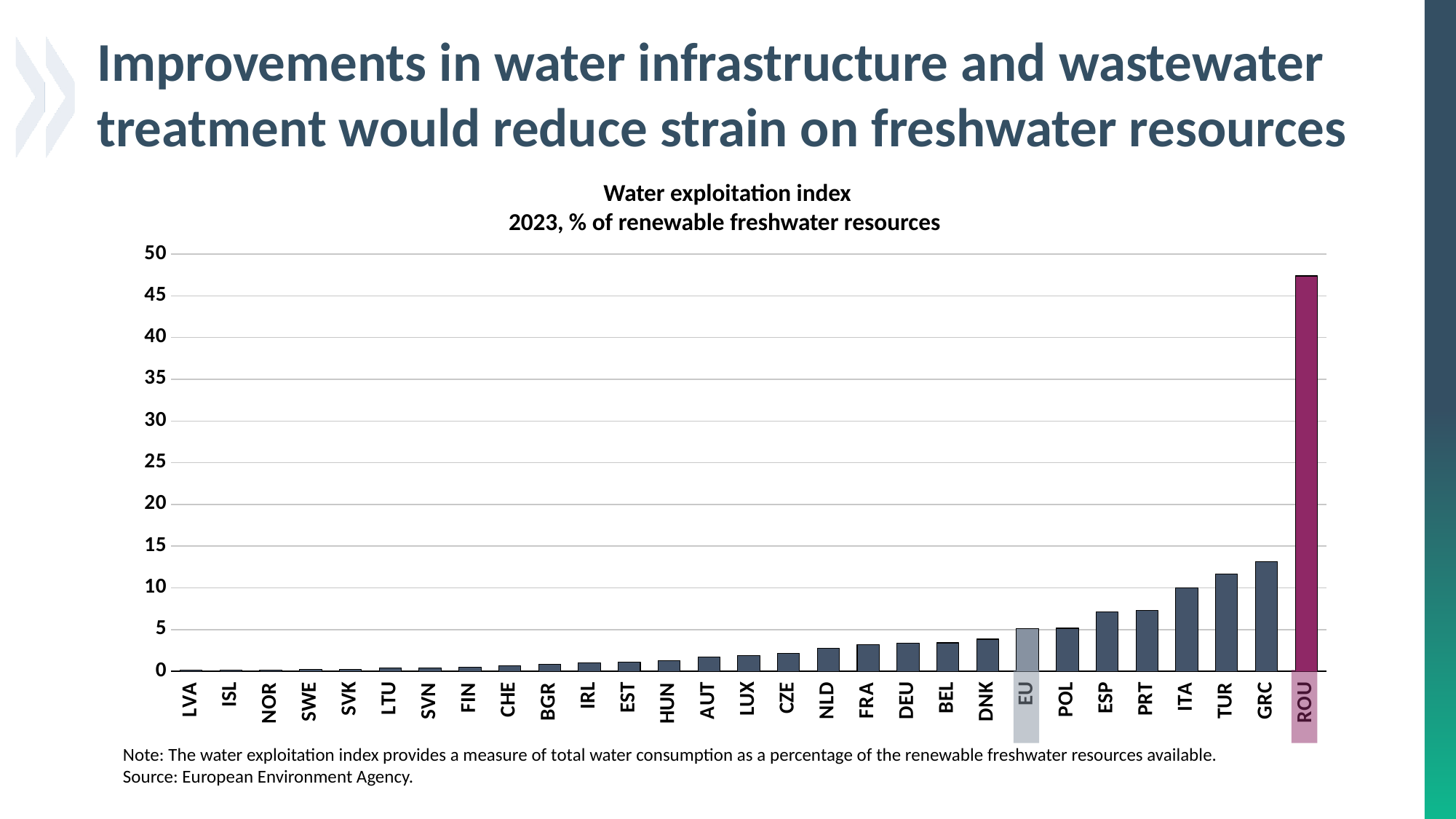
Which has a higher water exploitation index, FRA or LVA? FRA What is the title of the chart? Water exploitation index Is the value for ESP greater or less than 10? less Which country has the highest water exploitation index in the chart? ROU Which has a higher water exploitation index, TUR or ESP? TUR Is the value for TUR greater or less than 10? greater How many categories are shown on the x axis of the chart? 29 Is the value for ROU greater or less than 45? greater Do the bar values rise or fall moving from left to right along the x axis? rise What kind of chart is shown on the slide? bar chart